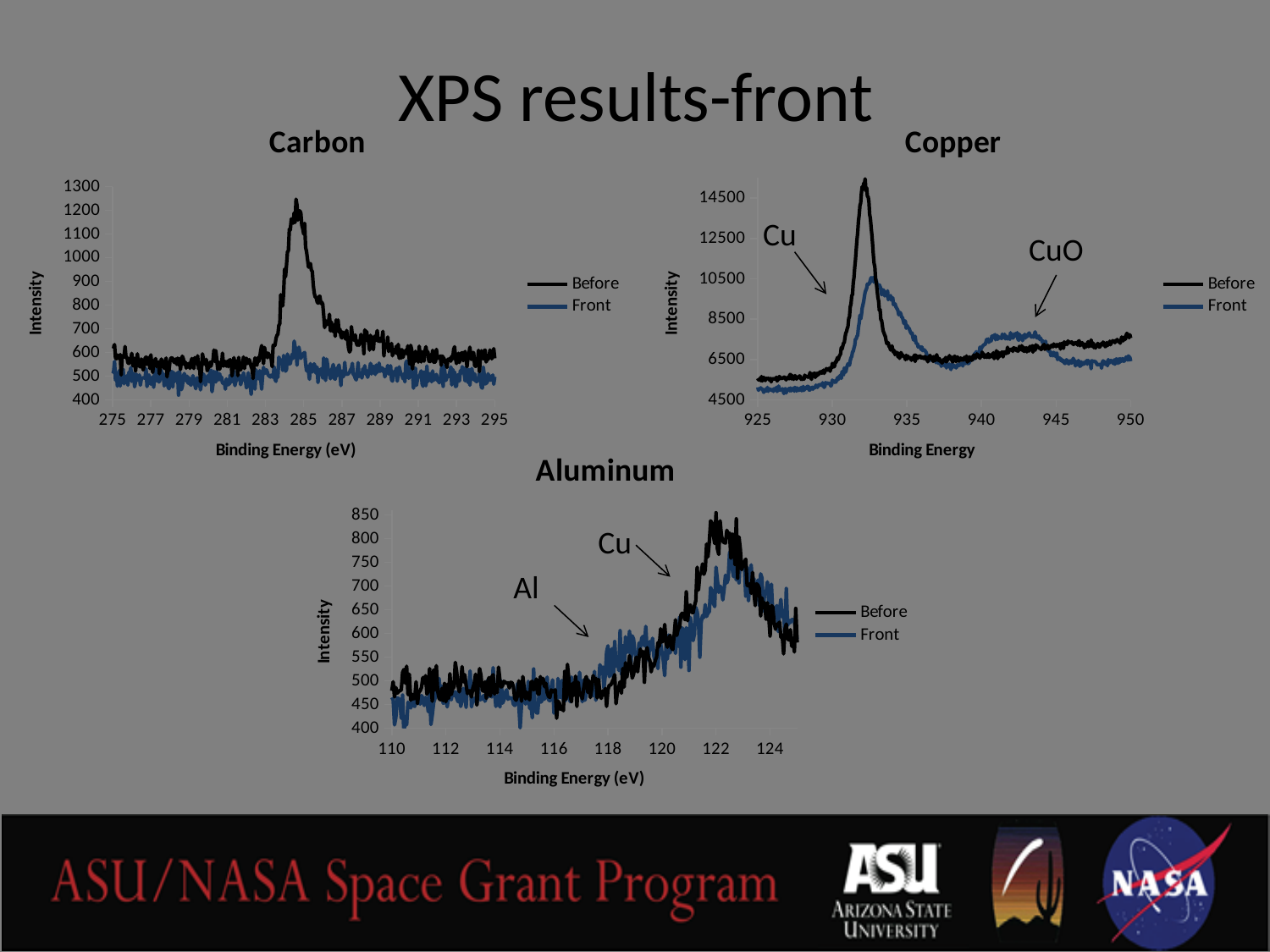
What is the x-axis title of the Carbon chart? Binding Energy (eV) In the Aluminum chart, is the peak value of the Before series greater or less than 750? greater In the Copper chart, is the peak value of the Before series greater or less than 14500? greater In the Carbon chart, which series has the higher peak, Before or Front? Before How many charts are shown on the slide? 3 In the Copper chart, is the peak value of the Front series greater or less than 12500? less In the Copper chart, which series reaches the higher peak intensity, Before or Front? Before What are the two series named in the legend of the Aluminum chart? Before and Front How many series does the legend of the Copper chart list? 2 What kind of chart is the Carbon chart? line chart